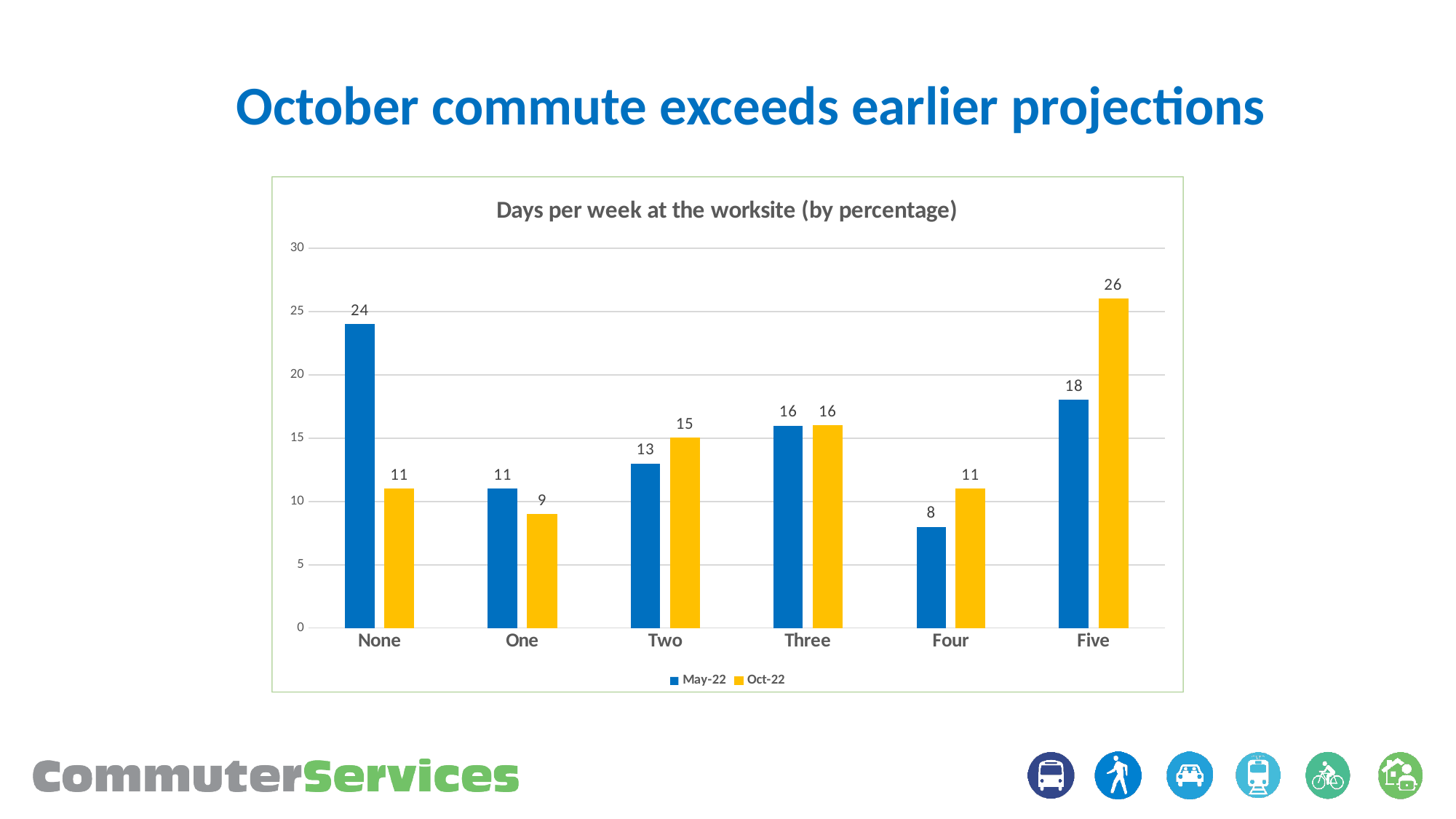
What is the Oct-22 value for One? 9 Which category has the lowest May-22 value? Four How many series does the legend list? 2 What is the Oct-22 value for Five? 26 Is the May-22 value for Two greater or less than 10? greater What is the May-22 value for None? 24 How many categories are shown on the x axis? 6 What kind of chart is shown? bar chart What is the difference between the Oct-22 and May-22 values for Five? 8 Which category has the highest Oct-22 value? Five What is the title of the chart? Days per week at the worksite (by percentage) Which is larger for None, the May-22 value or the Oct-22 value? May-22